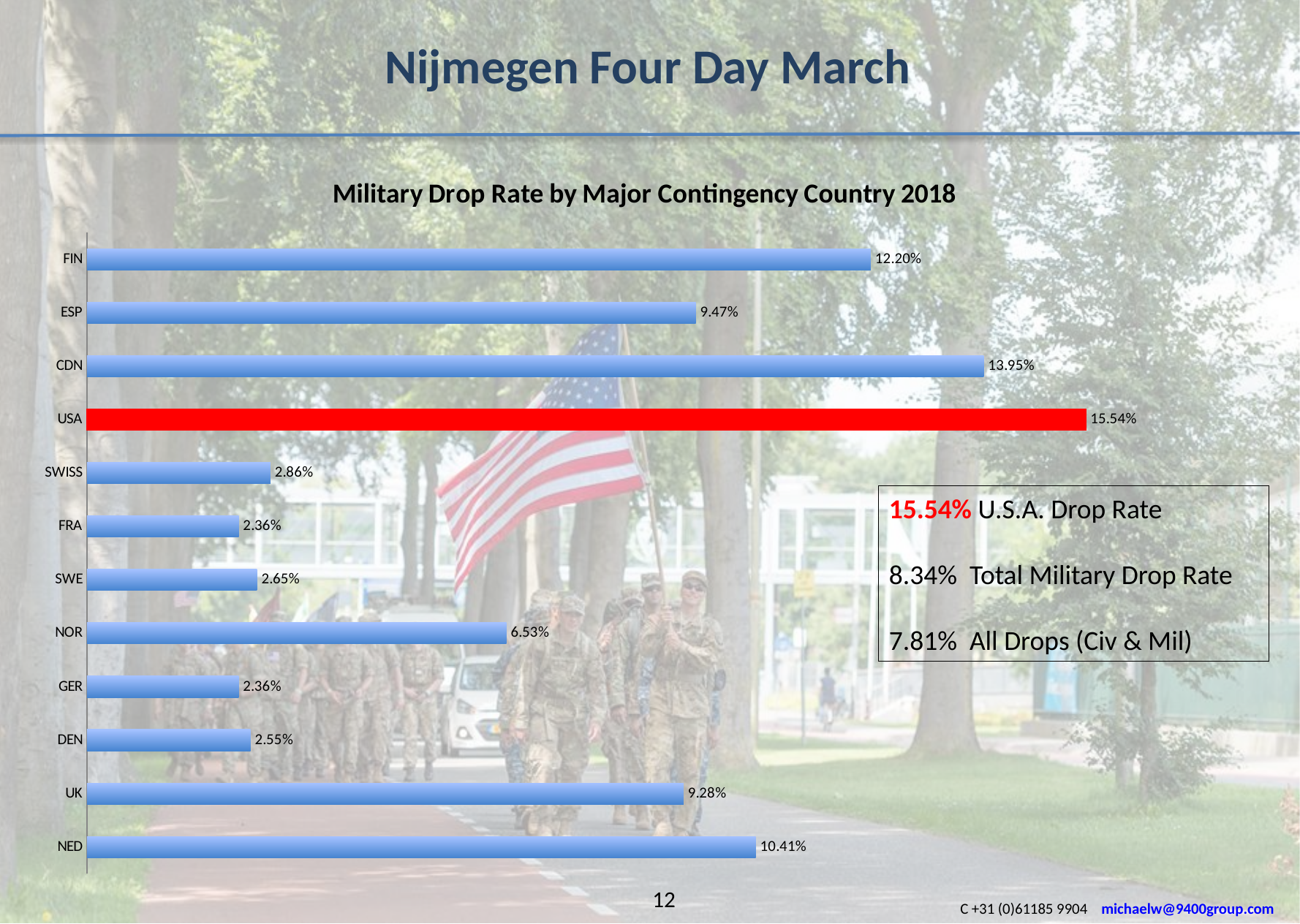
What is the military drop rate for NOR? 6.53% Which country's bar is coloured red instead of blue? USA Which country has the highest military drop rate? USA How many countries are shown in the chart? 12 What kind of chart is shown on the slide? Bar chart Which countries share the lowest military drop rate? FRA and GER What is the title of the chart? Military Drop Rate by Major Contingency Country 2018 What is the difference between the drop rates of SWISS and SWE? 0.21% What is the military drop rate for NED? 10.41% What is the difference between the drop rates of CDN and FIN? 1.75% What is the military drop rate for USA? 15.54% Which has a higher drop rate, ESP or UK? ESP